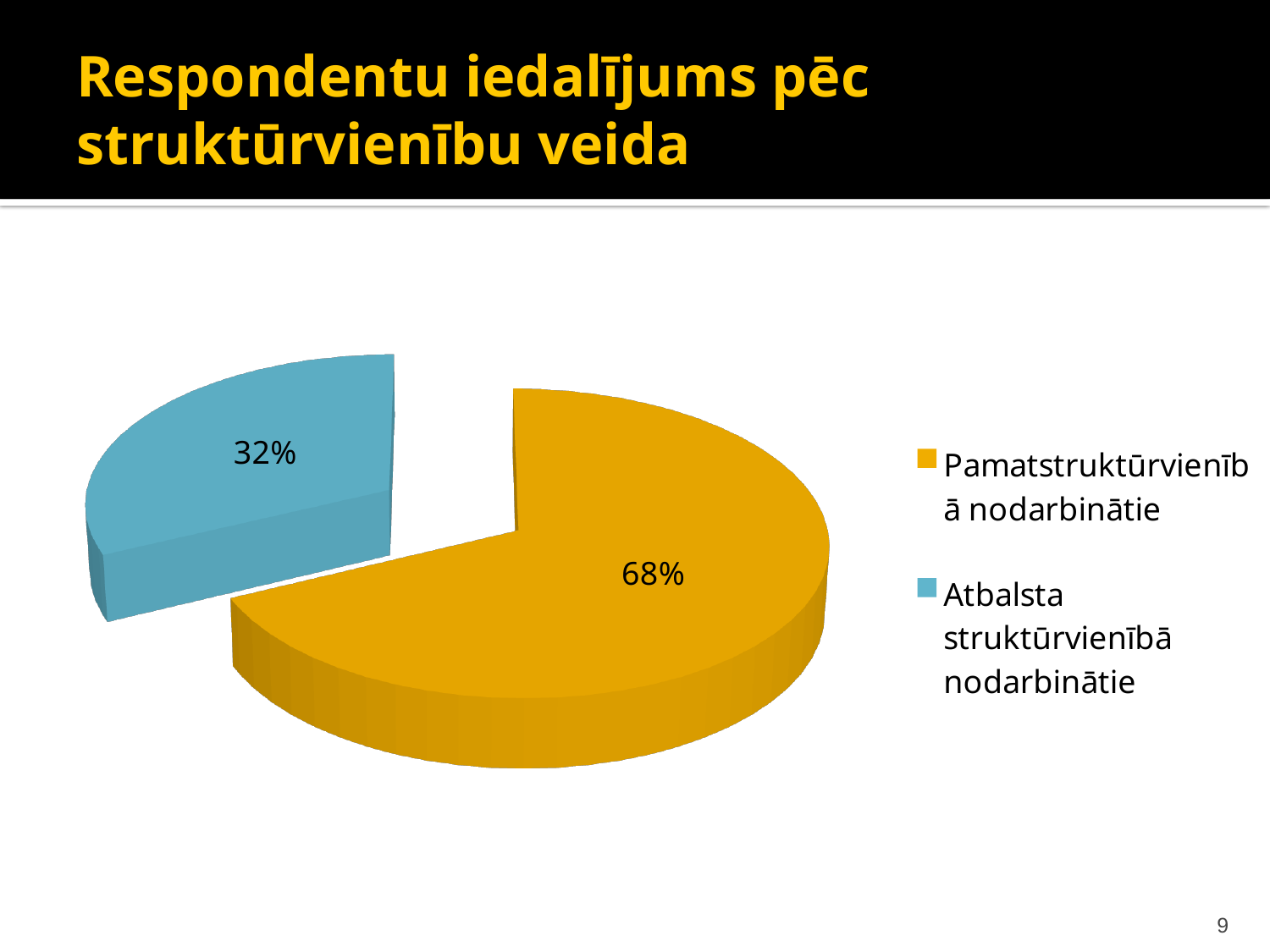
What colour is the slice for Atbalsta struktūrvienībā nodarbinātie? Blue What share of respondents are Atbalsta struktūrvienībā nodarbinātie? 32% What kind of chart is shown on the slide? Pie chart How many entries does the legend list? 2 How many slices does the pie chart have? 2 Which is larger: the share for Pamatstruktūrvienībā nodarbinātie or for Atbalsta struktūrvienībā nodarbinātie? Pamatstruktūrvienībā nodarbinātie What share of respondents are Pamatstruktūrvienībā nodarbinātie? 68% Which category has the largest share of the pie? Pamatstruktūrvienībā nodarbinātie What is the title of the slide? Respondentu iedalījums pēc struktūrvienību veida Which category has the smallest share of the pie? Atbalsta struktūrvienībā nodarbinātie What is the difference in percentage points between the Pamatstruktūrvienībā nodarbinātie and Atbalsta struktūrvienībā nodarbinātie slices? 36 percentage points